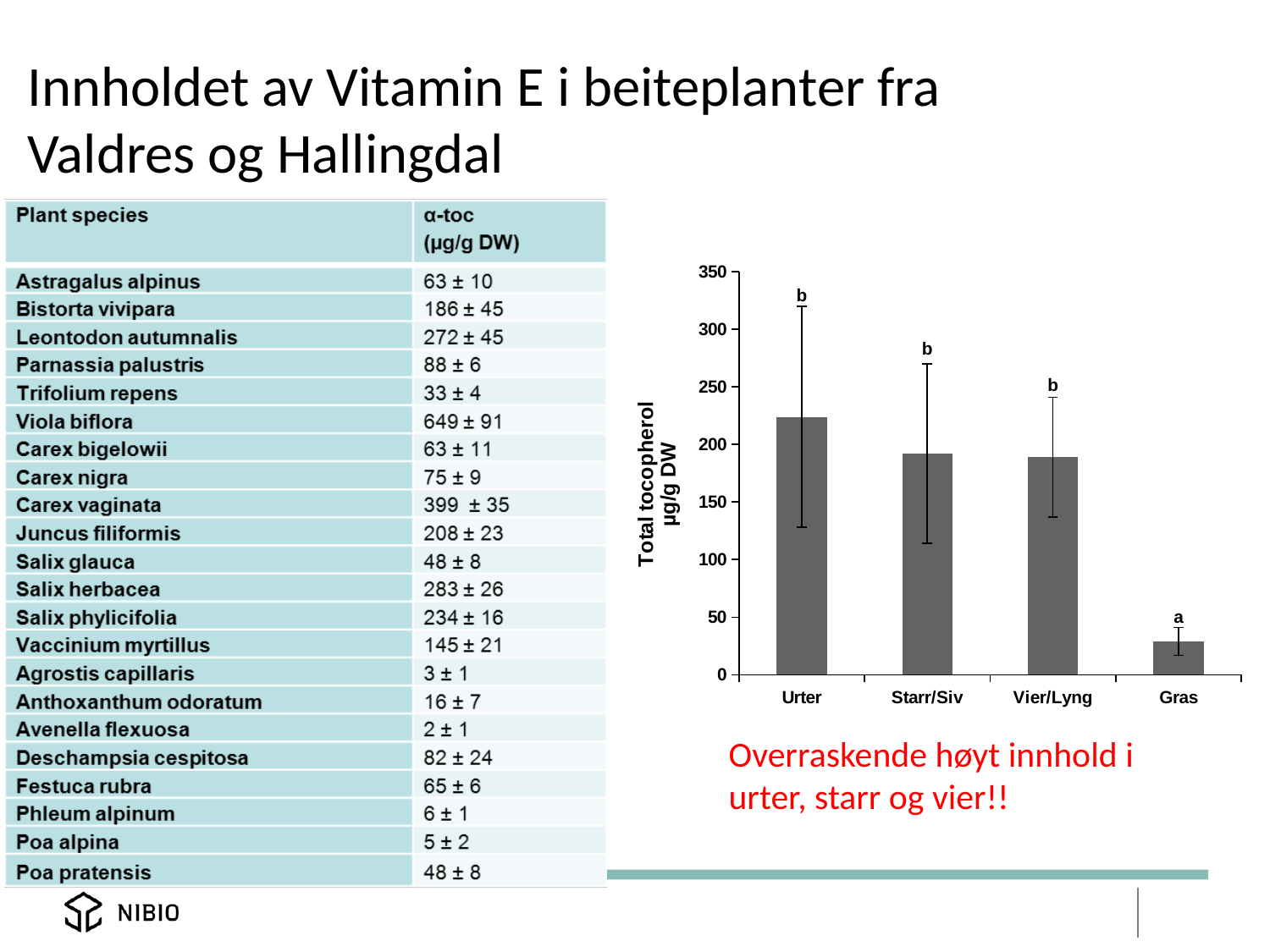
Which is larger, the value for Urter or the value for Starr/Siv? Urter Which category has the highest total tocopherol value in the bar chart? Urter What kind of chart is shown on the slide? bar chart Which letter is printed above the Gras bar in the bar chart? a Which is larger, the value for Urter or the value for Gras? Urter What is the label of the y axis of the bar chart? Total tocopherol µg/g DW Is the value for Starr/Siv greater or less than 150? greater Is the value for Vier/Lyng greater or less than 250? less Which category has the lowest total tocopherol value in the bar chart? Gras Is the value for Urter greater or less than 200? greater How many categories are shown on the x axis of the bar chart? 4